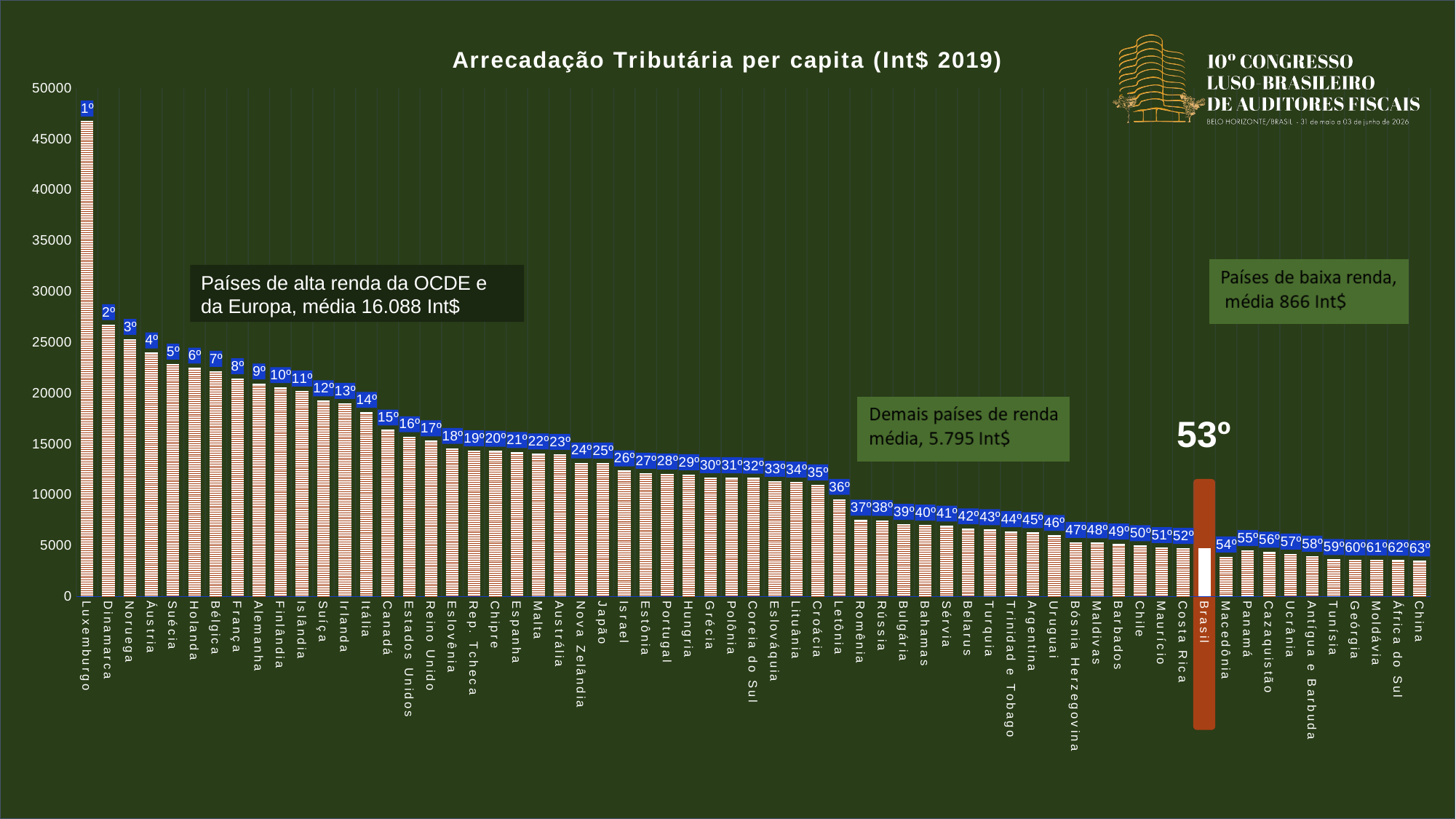
Do the bar values rise or fall from left to right along the x axis? fall What rank label is shown above the bar for Japão? 25º How many countries are plotted in the chart? 63 Which country has the highest tax revenue per capita in the chart? Luxemburgo What rank label is shown above the bar for Brasil? 53º Which has a higher tax revenue per capita, Dinamarca or Rússia? Dinamarca What kind of chart is shown on the slide? bar chart What rank label is shown above the bar for Canadá? 15º Is the value for Luxemburgo greater or less than 45000? greater Which country has the lowest tax revenue per capita in the chart? China Is the value for Japão greater or less than 10000? greater Is the value for Brasil greater or less than 10000? less